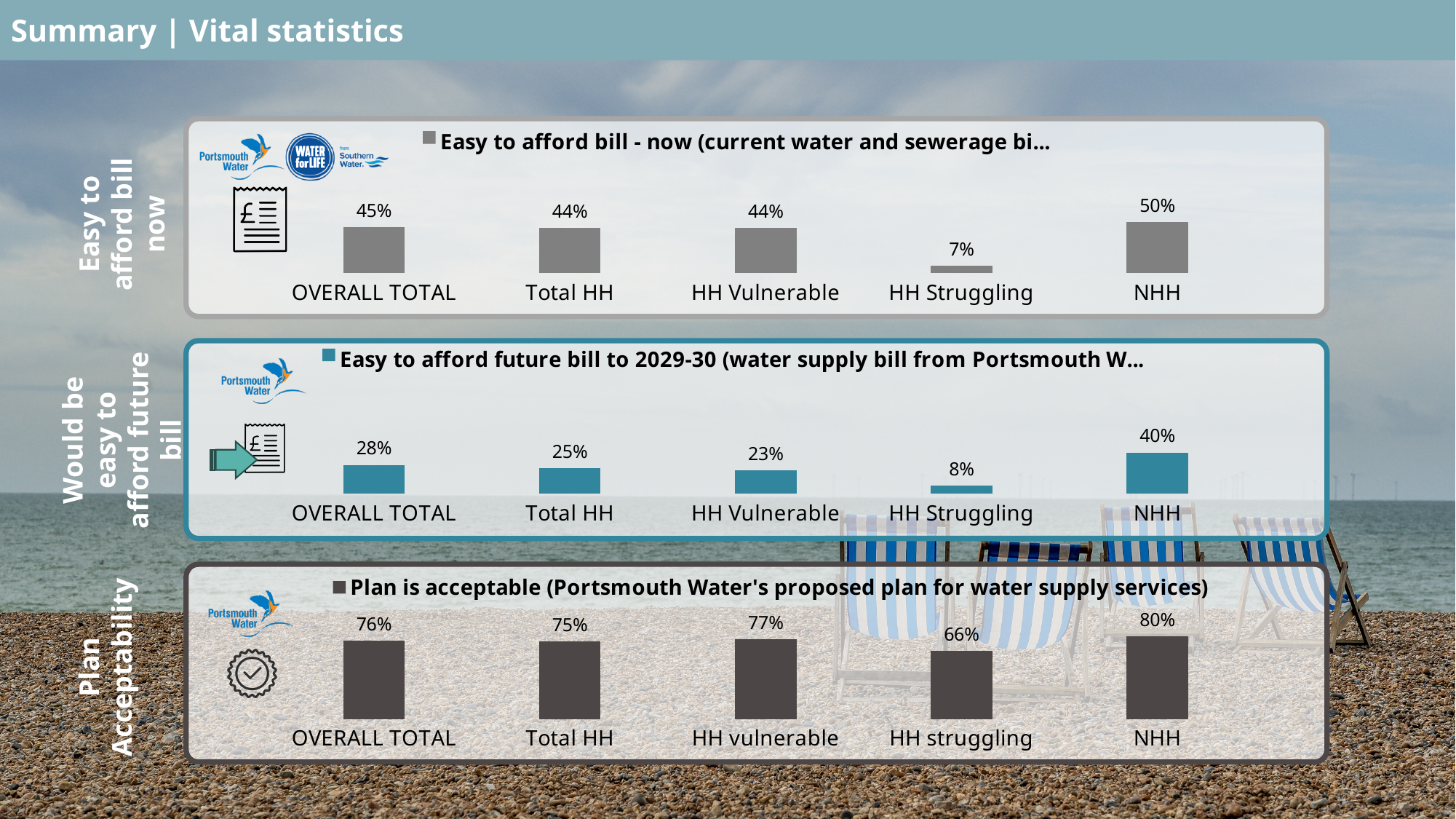
In the top chart (Easy to afford bill - now), which category has the highest value? NHH In the middle chart (Easy to afford future bill to 2029-30), which is larger, Total HH or HH Vulnerable? Total HH How many charts are shown on the slide? 3 In the top chart (Easy to afford bill - now), what is the difference between NHH and OVERALL TOTAL? 5% In the bottom chart (Plan is acceptable), what is the value for HH struggling? 66% In the top chart (Easy to afford bill - now), what is the value for HH Struggling? 7% In the middle chart (Easy to afford future bill to 2029-30), what is the difference between NHH and HH Struggling? 32% What type of chart is the bottom chart (Plan is acceptable)? Bar chart In the middle chart (Easy to afford future bill to 2029-30), which category has the lowest value? HH Struggling In the bottom chart (Plan is acceptable), how many categories are shown? 5 In the bottom chart (Plan is acceptable), which category has the highest value? NHH In the middle chart (Easy to afford future bill to 2029-30), what is the value for OVERALL TOTAL? 28%